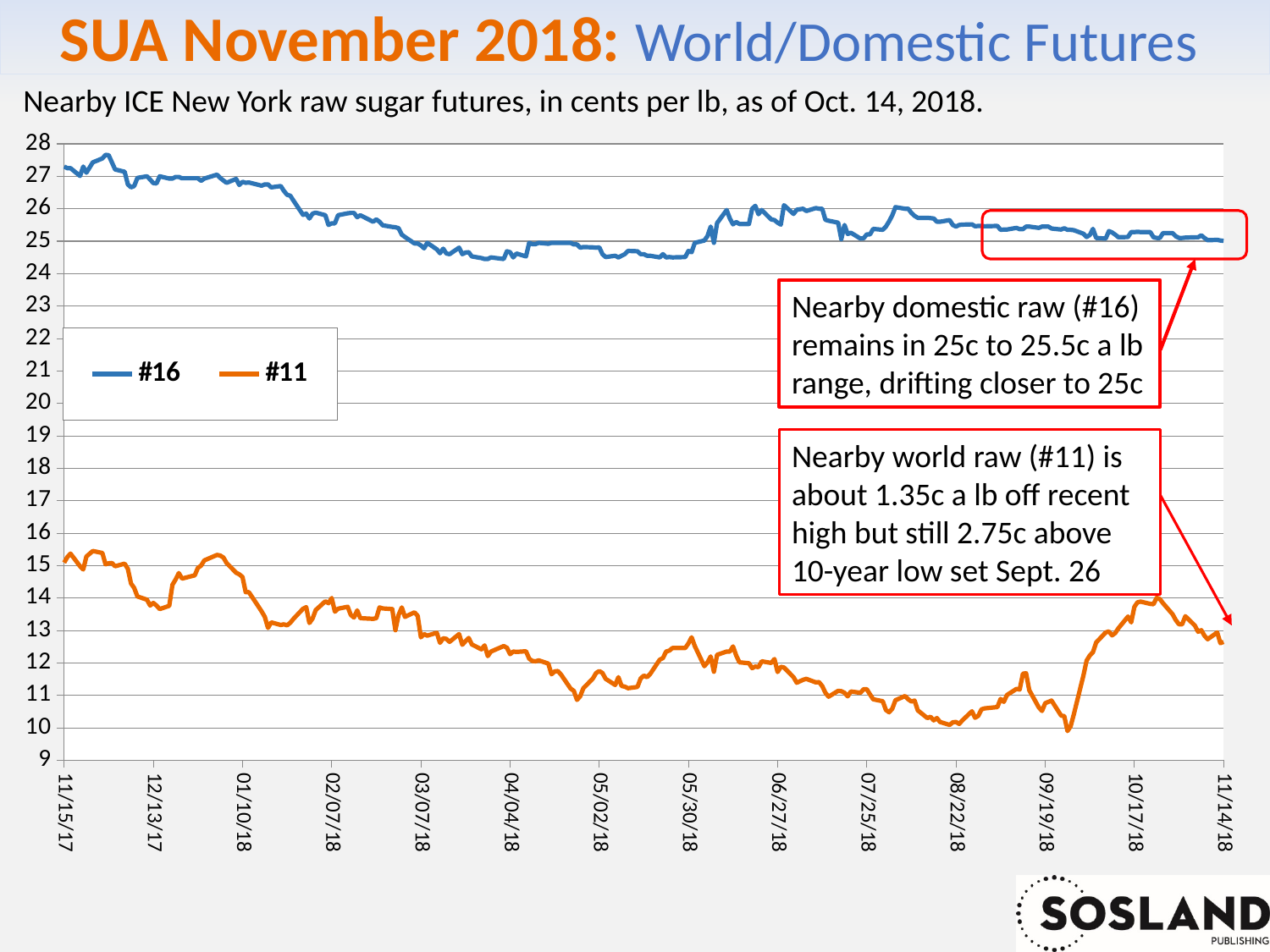
How many series does the chart legend list? 2 Is the value of #11 at 08/22/18 greater or less than 11? less What are the two series named in the chart legend? #16 and #11 Which series has the higher value at 06/27/18, #16 or #11? #16 What colour is the #11 line in the chart? orange How many date labels are shown on the x axis? 14 Is the lowest point of the #11 line greater or less than 11? less Is the value of #16 at 11/15/17 greater or less than 26? greater Does the #16 line rise or fall overall from 11/15/17 to 11/14/18? fall What kind of chart is shown on the slide? line chart